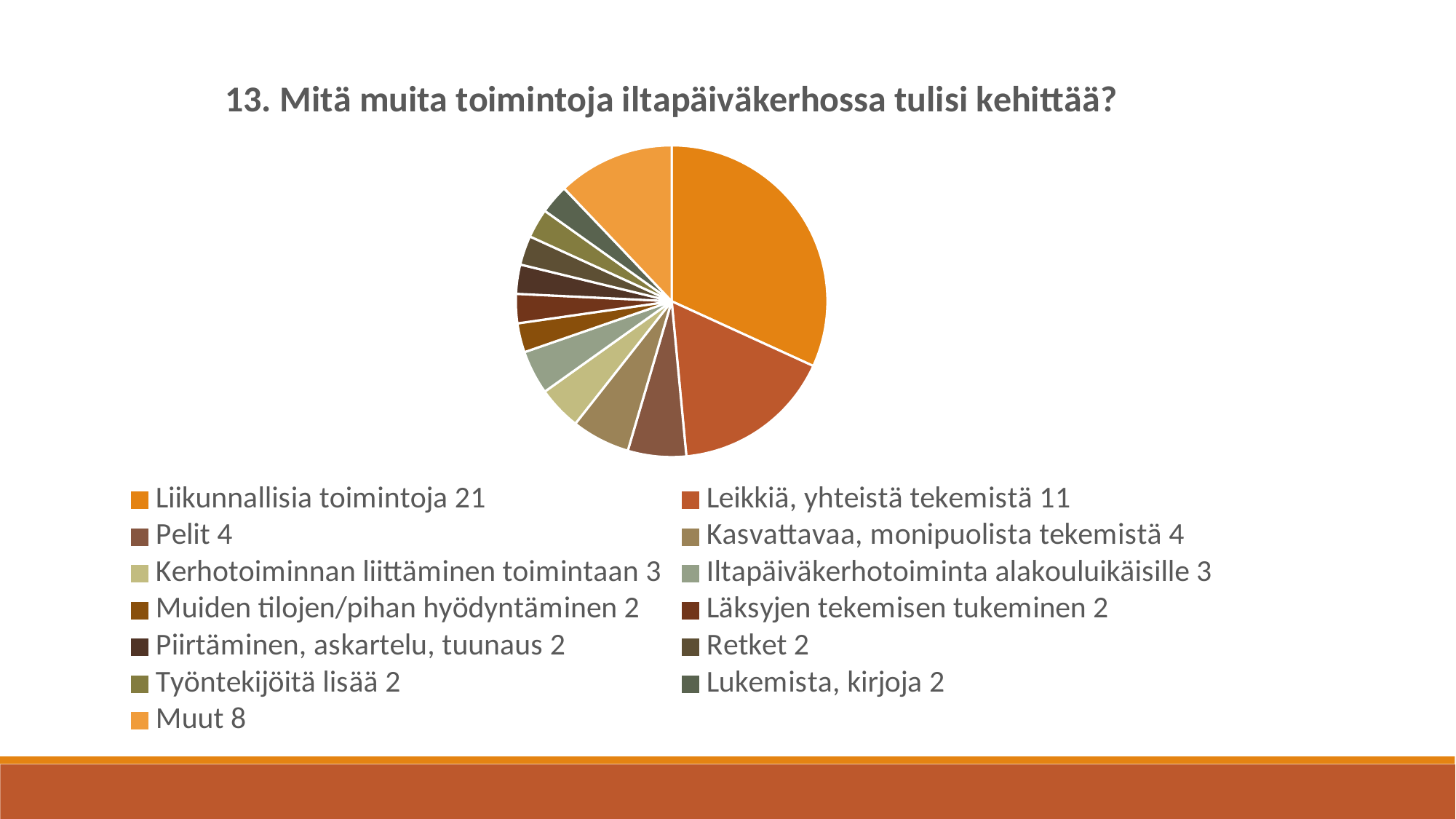
What is the value for Kerhotoiminnan liittäminen toimintaan? 3 What is the value for Liikunnallisia toimintoja? 21 What is the value for Muut? 8 What is the lowest value shown in the legend? 2 Which is larger, the value for Pelit or the value for Muut? Muut What is the value for Leikkiä, yhteistä tekemistä? 11 What kind of chart is shown on the slide? pie chart What is the title of the chart? 13. Mitä muita toimintoja iltapäiväkerhossa tulisi kehittää? Which category has the largest slice of the pie? Liikunnallisia toimintoja How many categories does the pie chart have? 13 What is the total of all the values shown in the legend? 66 What is the difference between the values for Liikunnallisia toimintoja and Leikkiä, yhteistä tekemistä? 10